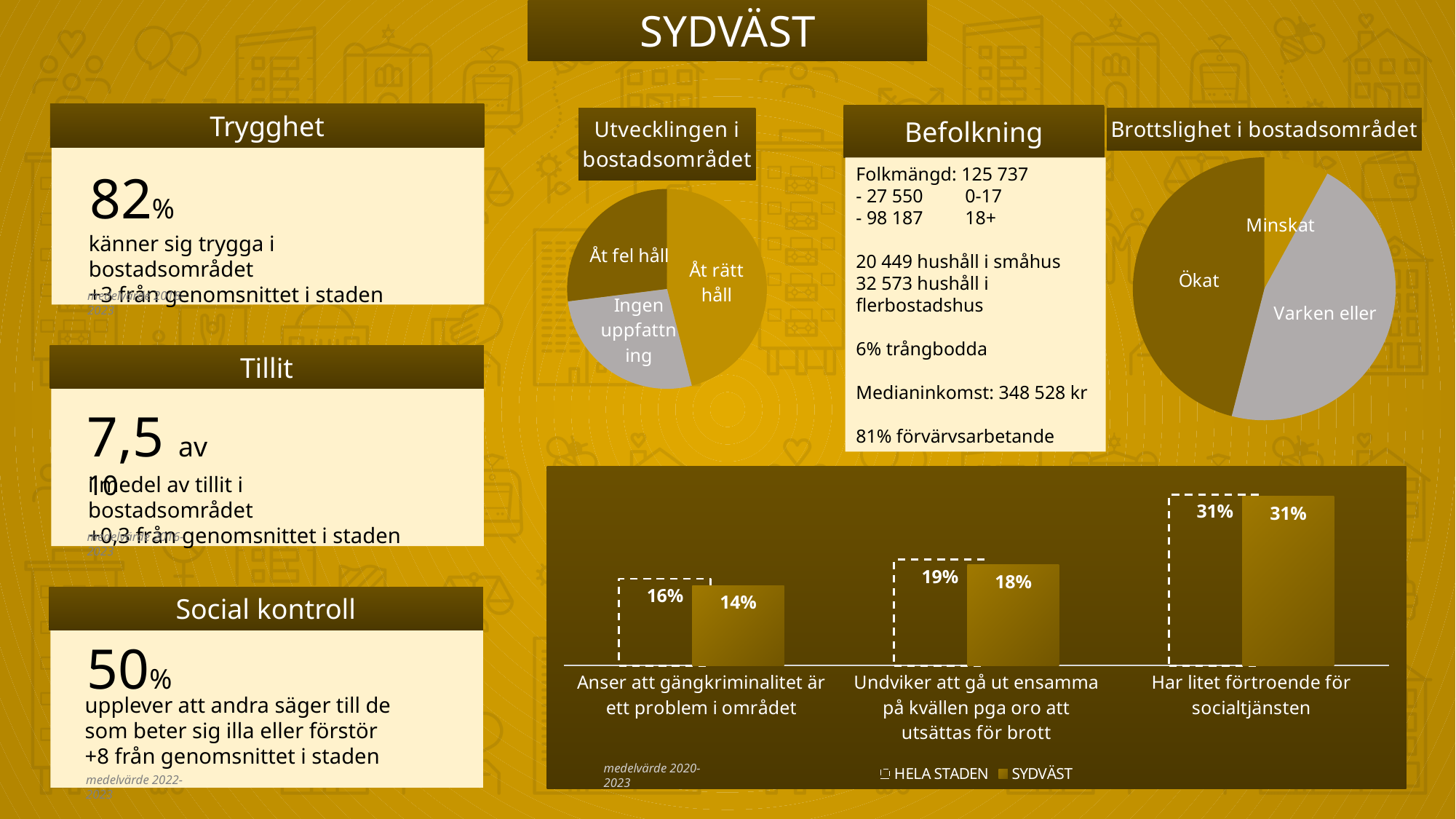
In the bar chart at the bottom of the slide, which category has the lowest value for HELA STADEN? Anser att gängkriminalitet är ett problem i området In the bar chart at the bottom of the slide, what is the difference between HELA STADEN and SYDVÄST for 'Anser att gängkriminalitet är ett problem i området'? 2% In the bar chart at the bottom of the slide, what is the value for SYDVÄST for 'Anser att gängkriminalitet är ett problem i området'? 14% In the 'Brottslighet i bostadsområdet' pie chart, which slice is the smallest? Minskat In the bar chart at the bottom of the slide, which category has the highest value for SYDVÄST? Har litet förtroende för socialtjänsten In the bar chart at the bottom of the slide, which is larger for 'Undviker att gå ut ensamma på kvällen pga oro att utsättas för brott': HELA STADEN or SYDVÄST? HELA STADEN What kind of chart is the 'Utvecklingen i bostadsområdet' chart? Pie chart In the 'Utvecklingen i bostadsområdet' pie chart, which slice is the largest? Åt rätt håll How many series does the legend of the bar chart at the bottom of the slide list? 2 How many categories are shown in the bar chart at the bottom of the slide? 3 In the bar chart at the bottom of the slide, what is the value for SYDVÄST for 'Har litet förtroende för socialtjänsten'? 31% In the bar chart at the bottom of the slide, what is the value for HELA STADEN for 'Undviker att gå ut ensamma på kvällen pga oro att utsättas för brott'? 19%